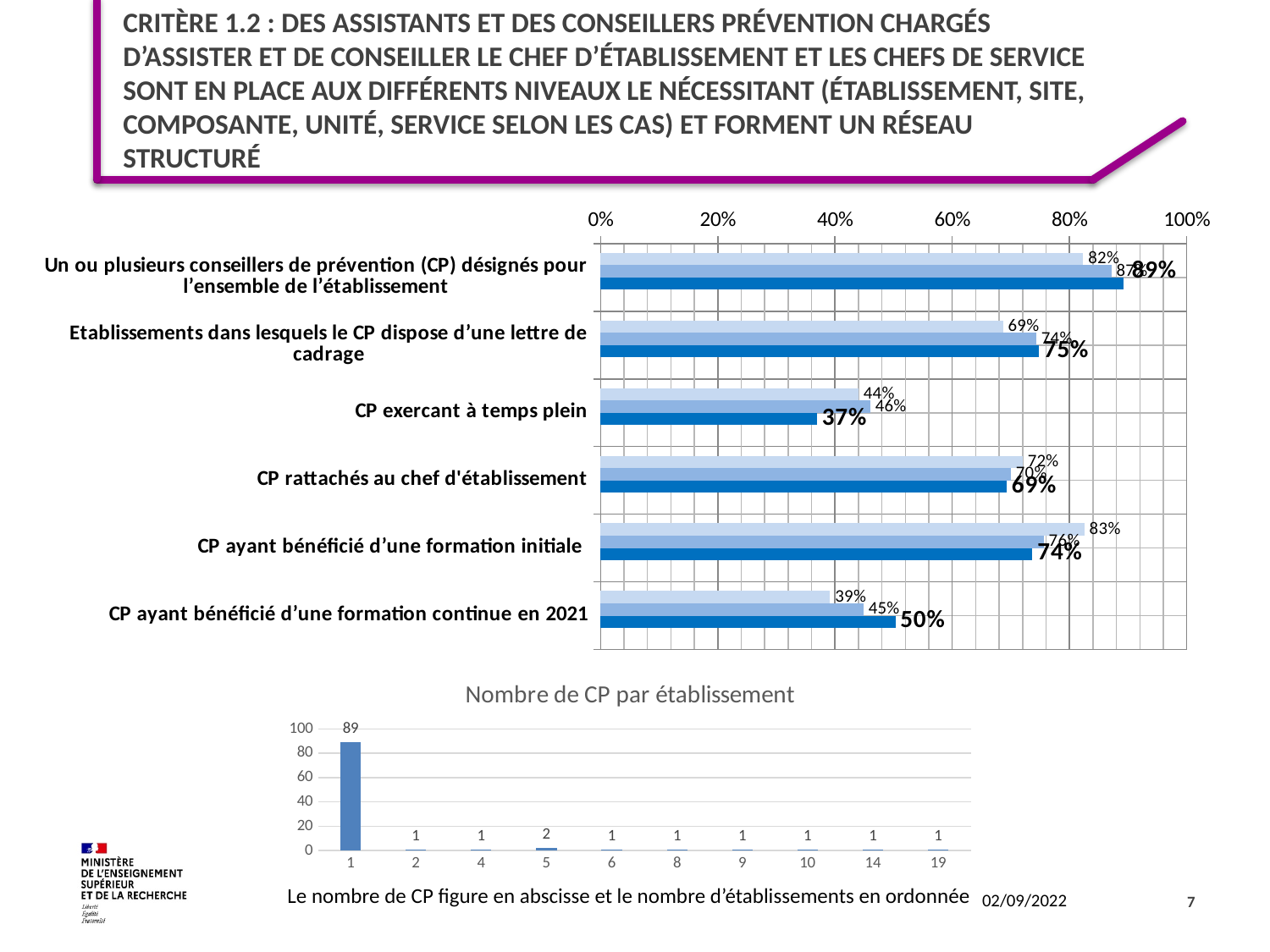
In the top chart, what is the value of the light blue bar for 'CP ayant bénéficié d’une formation initiale'? 83% In the chart titled 'Nombre de CP par établissement', what is the difference between the values for category 1 and category 5? 87 In the chart titled 'Nombre de CP par établissement', what is the value for category 1? 89 In the chart titled 'Nombre de CP par établissement', which category has the highest value? 1 What kind of chart is the chart titled 'Nombre de CP par établissement'? bar chart In the top chart, what is the value of the dark blue bar for 'CP exercant à temps plein'? 37% In the top chart, is the dark blue bar for 'CP exercant à temps plein' greater or less than 40%? less In the chart titled 'Nombre de CP par établissement', how many categories are shown on the x axis? 10 In the top chart, how many categories are listed on the vertical axis? 6 In the chart titled 'Nombre de CP par établissement', what is the value for category 5? 2 In the top chart, what is the value of the dark blue bar for 'CP ayant bénéficié d’une formation continue en 2021'? 50% In the top chart, what is the value of the light blue bar for 'Un ou plusieurs conseillers de prévention (CP) désignés pour l’ensemble de l’établissement'? 82%